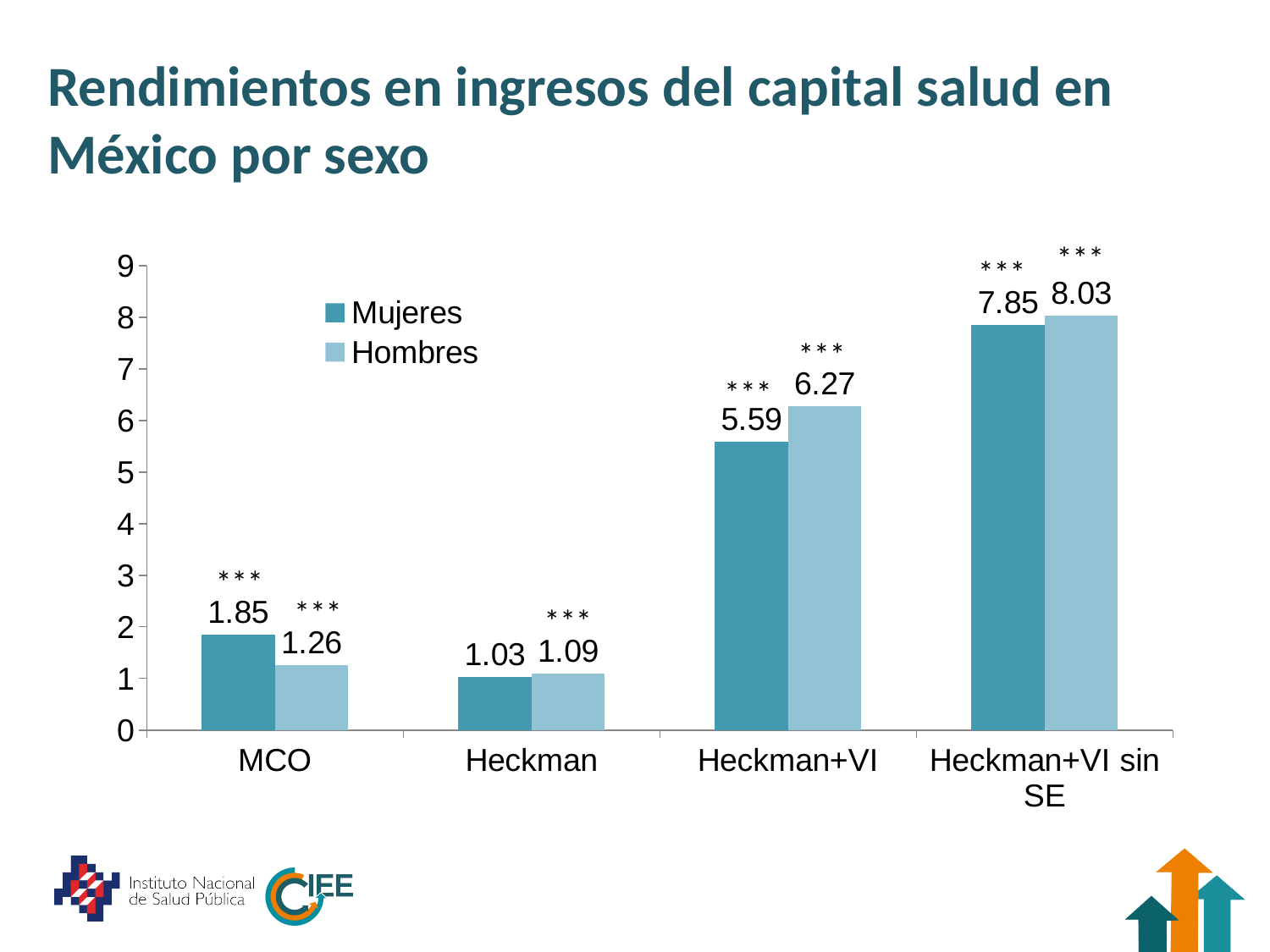
What is the difference between the Hombres and Mujeres values in the Heckman+VI category? 0.68 In the MCO category, which series has the larger value, Mujeres or Hombres? Mujeres What is the value for Mujeres in the Heckman+VI sin SE category? 7.85 What kind of chart is shown on the slide? Bar chart How many series does the legend list? 2 What is the title of the slide? Rendimientos en ingresos del capital salud en México por sexo What is the value for Hombres in the Heckman+VI category? 6.27 How many categories are shown on the x axis? 4 What is the value for Mujeres in the MCO category? 1.85 Which category has the lowest value for Mujeres? Heckman Which category has the highest value for Hombres? Heckman+VI sin SE What is the value for Hombres in the Heckman category? 1.09